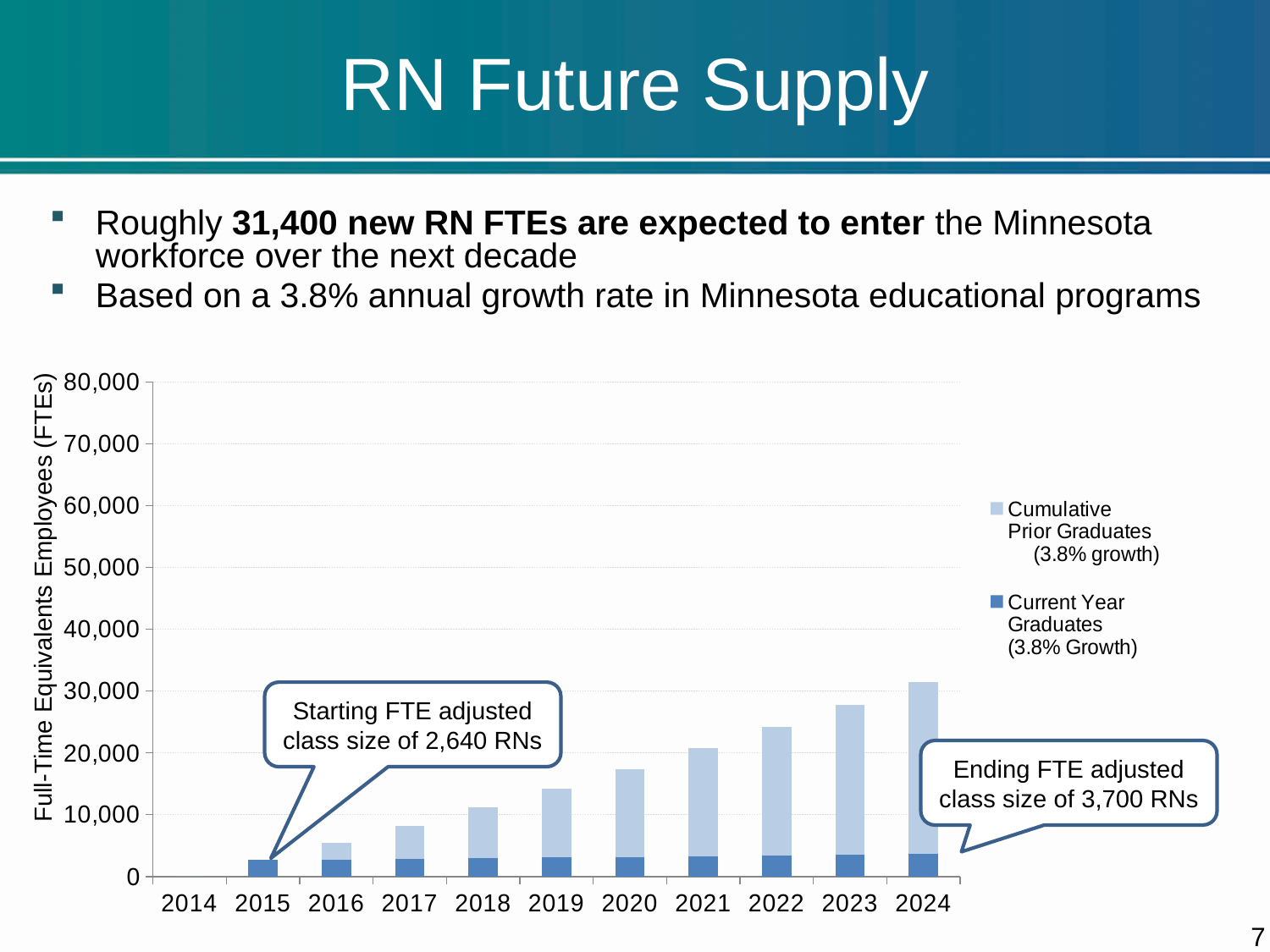
Is the total bar height for 2016 greater or less than 10,000? less According to the callout pointing to the 2024 bar, what is the ending FTE adjusted class size? 3,700 RNs What is the label of the y axis of the chart? Full-Time Equivalents Employees (FTEs) How many year labels are shown along the x axis of the chart? 11 What kind of chart is shown on the slide? Stacked bar chart Is the total bar height for 2022 greater or less than 20,000? greater Is the total bar height for 2023 greater or less than 30,000? less Among the years with a visible bar, which year has the shortest bar? 2015 How many series does the chart legend list? 2 Which year has the tallest bar in the chart? 2024 Do the total bar heights rise or fall from 2015 to 2024? Rise